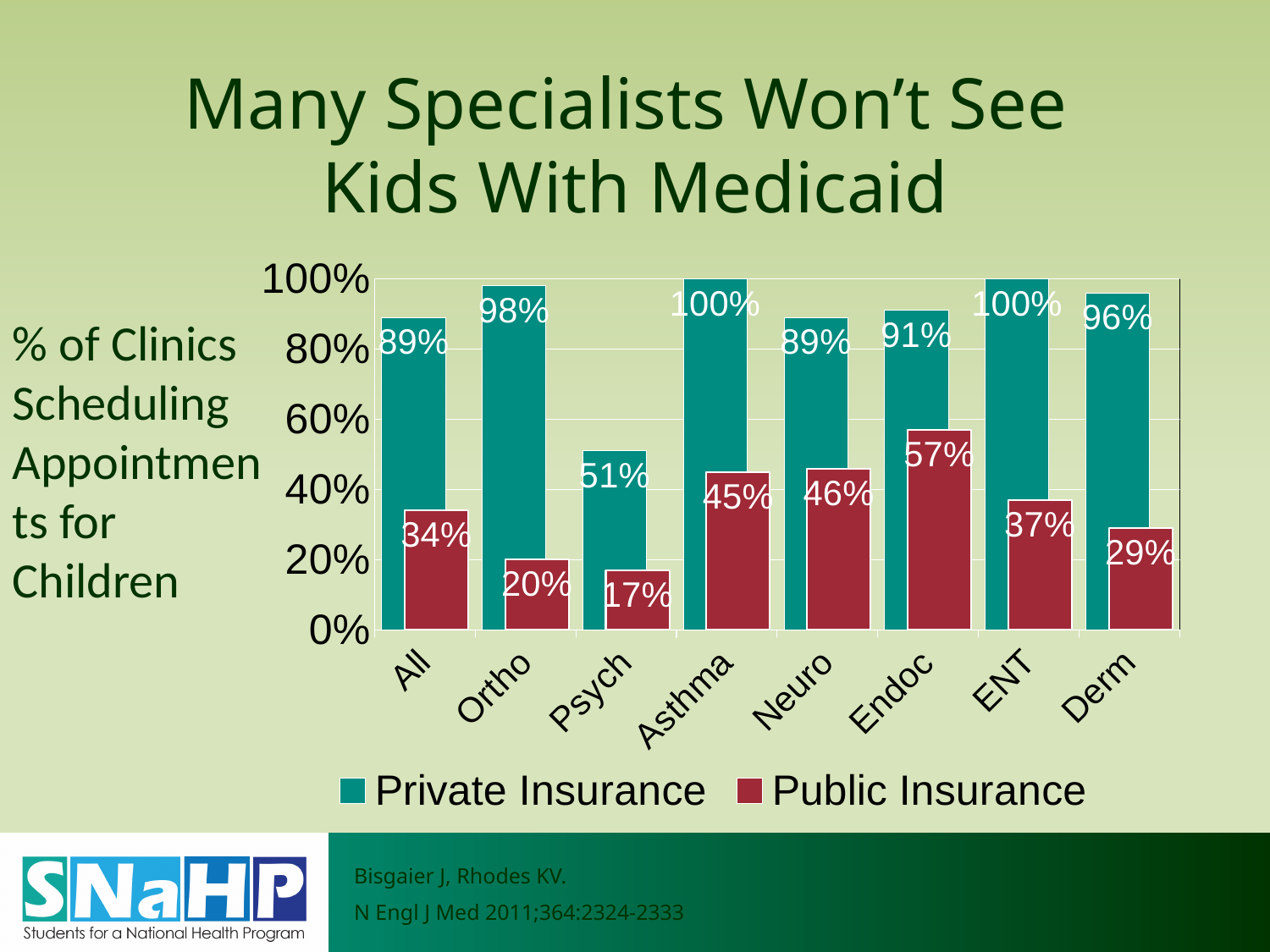
What is the Private Insurance value for Ortho? 98% What is the Public Insurance value for Derm? 29% Is the Public Insurance value for Neuro greater or less than 60%? less What is the Public Insurance value for Endoc? 57% What is the difference between the Private Insurance and Public Insurance values for All? 55 percentage points Which is larger for Asthma: the Private Insurance value or the Public Insurance value? Private Insurance Which category has the lowest Private Insurance value? Psych Which category has the lowest Public Insurance value? Psych How many series does the legend list? 2 Which category has the highest Public Insurance value? Endoc What kind of chart is shown on the slide? Bar chart How many categories are shown on the x axis? 8